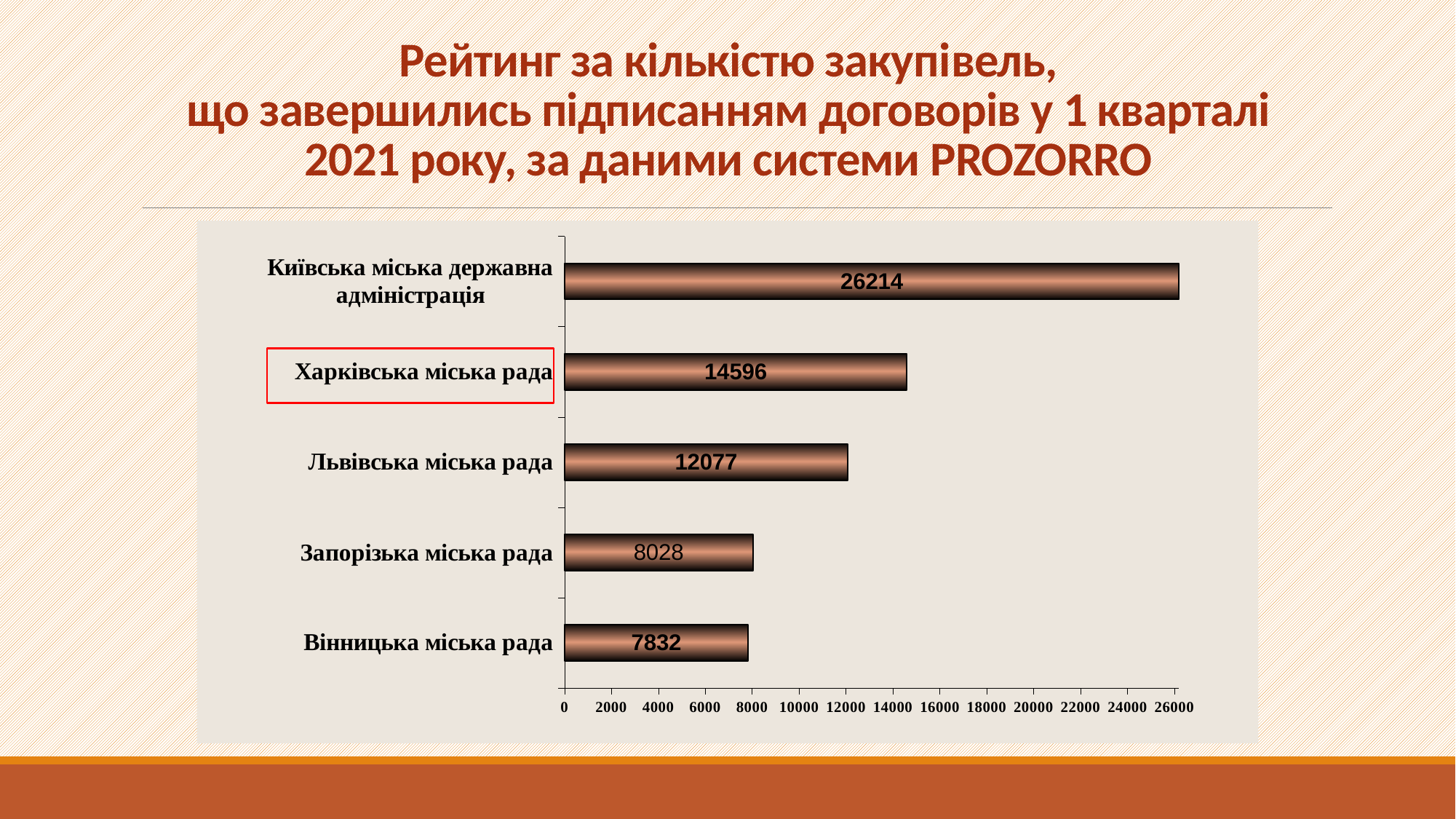
What is the difference between the values for Запорізька міська рада and Вінницька міська рада? 196 What is the value for Вінницька міська рада? 7832 What kind of chart is shown on the slide? bar chart Which is larger, the value for Львівська міська рада or the value for Запорізька міська рада? Львівська міська рада What is the difference between the values for Київська міська державна адміністрація and Харківська міська рада? 11618 Is the value for Харківська міська рада greater or less than 14000? greater Which category has the lowest value? Вінницька міська рада Which category has the highest value? Київська міська державна адміністрація What is the value for Львівська міська рада? 12077 Which category label is outlined with a red box? Харківська міська рада How many categories are shown in the chart? 5 What is the value for Харківська міська рада? 14596